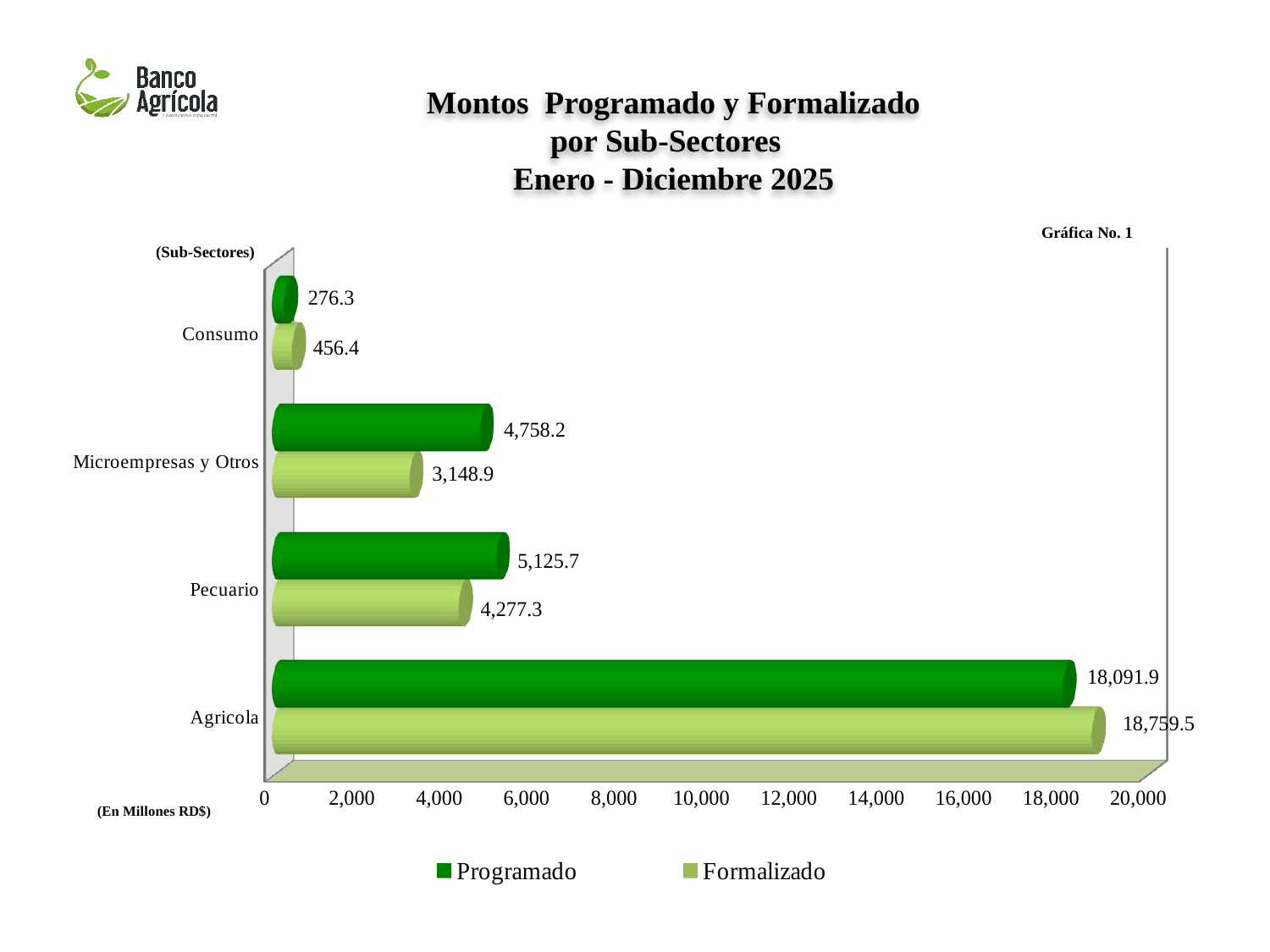
What is the Programado value for Agricola? 18,091.9 What is the Formalizado value for Consumo? 456.4 What is the Programado value for Microempresas y Otros? 4,758.2 How many series does the legend list? 2 What is the difference between the Formalizado and Programado values for Agricola? 667.6 What is the Formalizado value for Pecuario? 4,277.3 Which is larger for Microempresas y Otros, Programado or Formalizado? Programado Which sub-sector has the lowest Programado value? Consumo Which sub-sector has the highest Formalizado value? Agricola How many sub-sectors are shown on the chart? 4 What kind of chart is shown on the slide? Bar chart What unit is stated for the values on the chart? En Millones RD$